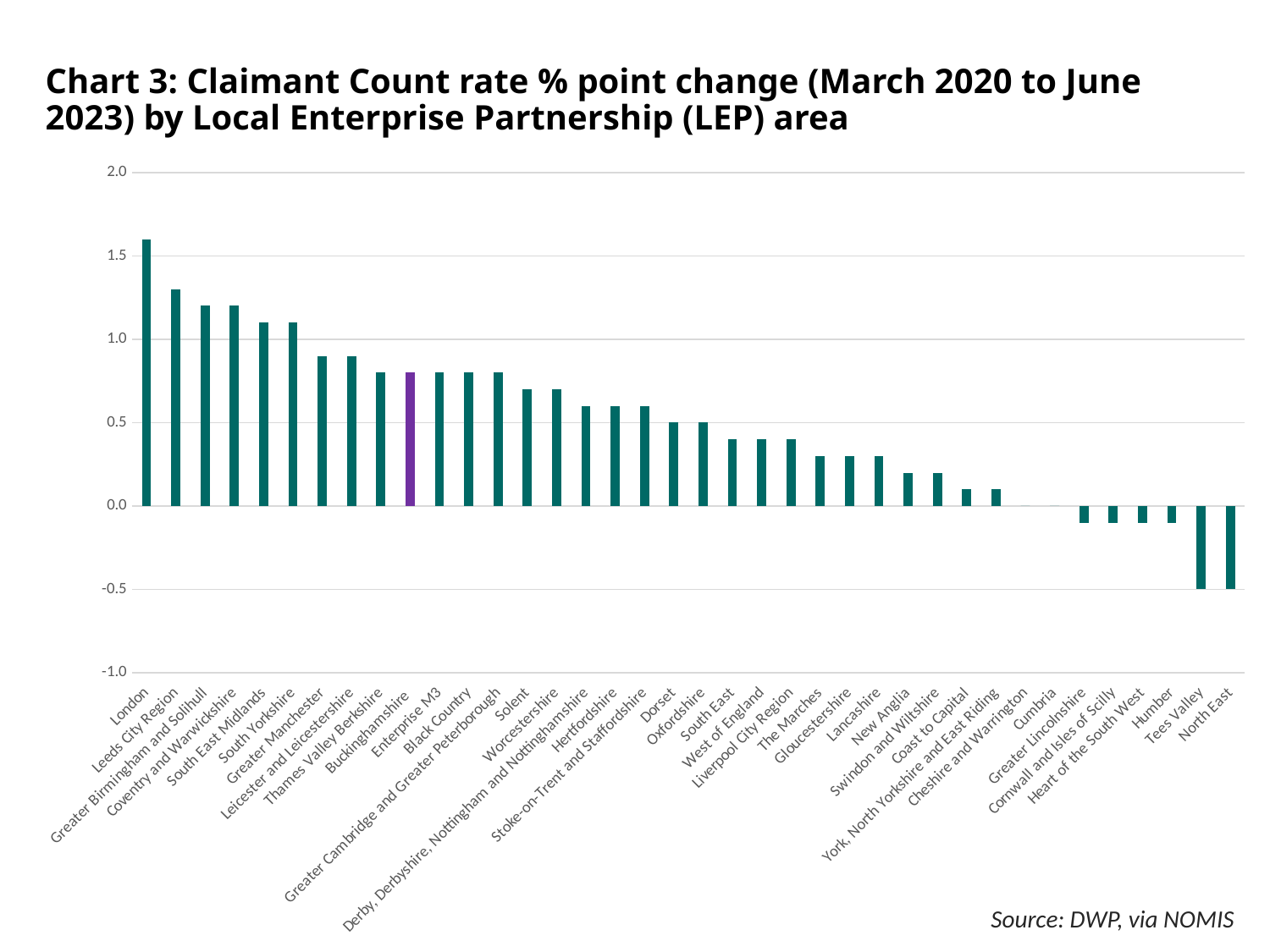
Is the value for Solent greater or less than 0.5? greater Which LEP area has the highest Claimant Count rate % point change? London Is the value for Humber greater or less than 0.0? less Which LEP area is highlighted with a purple bar? Buckinghamshire What kind of chart is shown on the slide? Bar chart Is the value for Leeds City Region greater or less than 1.0? greater Which has the larger value, London or Leeds City Region? London Do the values generally rise or fall moving from left to right along the x axis? Fall What is the source given for the chart? DWP, via NOMIS Which has the larger value, Dorset or Humber? Dorset